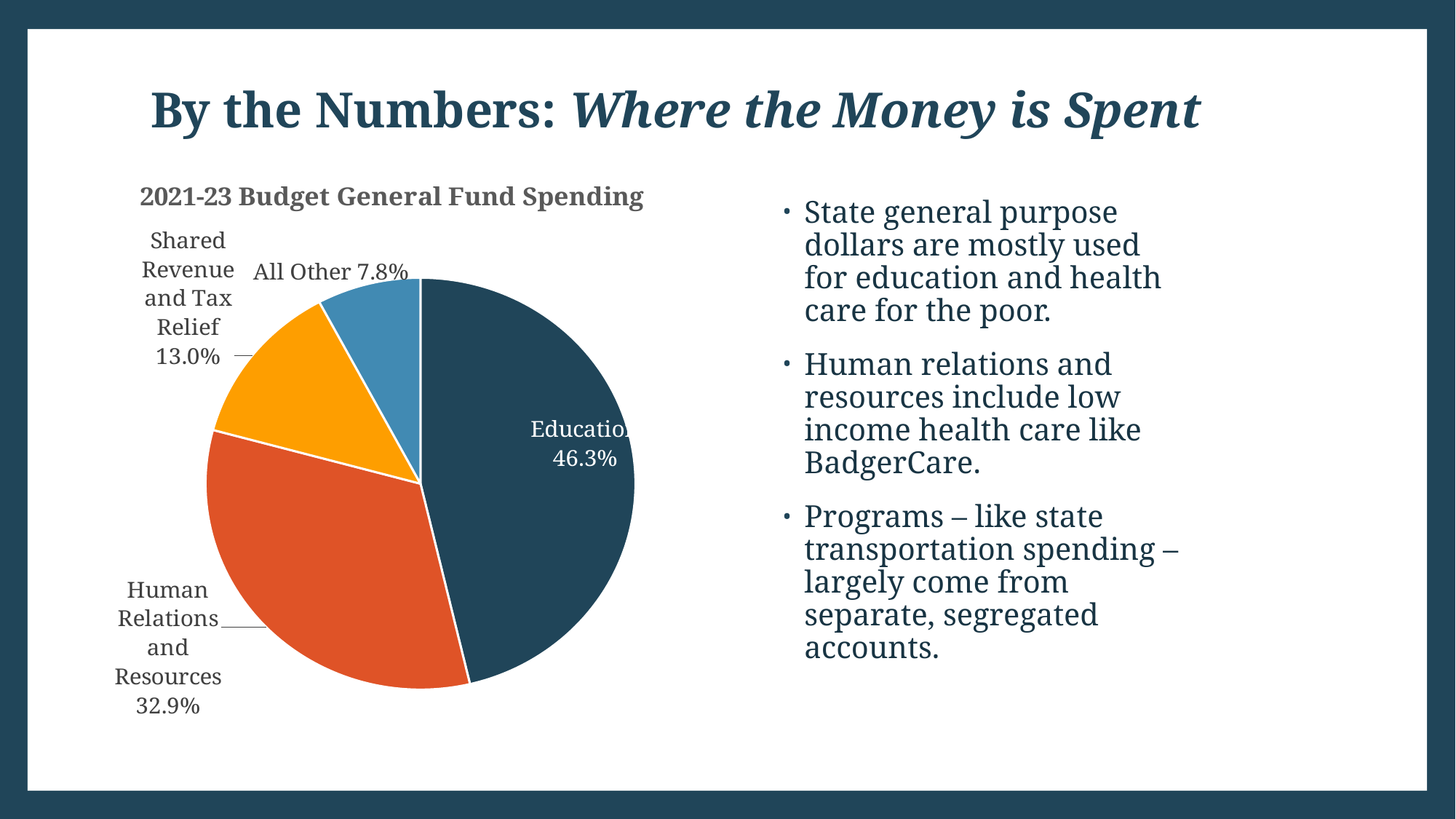
What share of the pie is Human Relations and Resources? 32.9% What percentage is shown for Shared Revenue and Tax Relief? 13.0% What colour is the Human Relations and Resources slice? Orange-red What is the difference in percentage points between Education and Human Relations and Resources? 13.4 Which category has the largest share of general fund spending? Education How many categories are shown in the pie chart? 4 What share of 2021-23 Budget General Fund Spending goes to Education? 46.3% Which category has the smallest share of general fund spending? All Other What kind of chart is shown on the slide? Pie chart What percentage is shown for All Other? 7.8% Which is larger: Shared Revenue and Tax Relief or All Other? Shared Revenue and Tax Relief What is the title of the chart? 2021-23 Budget General Fund Spending